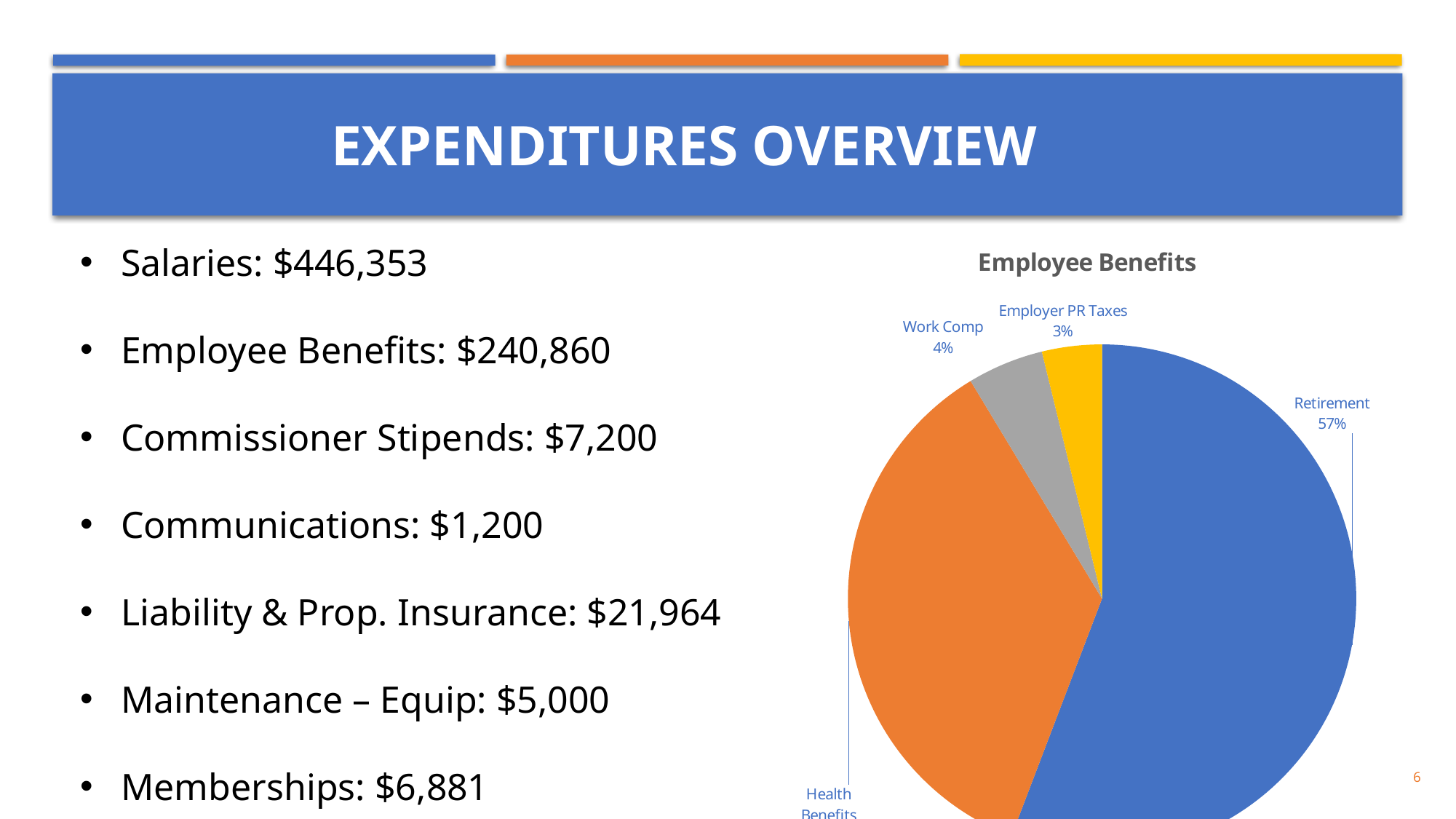
What share of the Employee Benefits pie is Work Comp? 4% Which is larger in the Employee Benefits pie, Work Comp or Employer PR Taxes? Work Comp What share of the Employee Benefits pie is Employer PR Taxes? 3% What colour is the Retirement slice in the Employee Benefits pie? Blue What is the title of the chart? Employee Benefits By how many percentage points does Retirement exceed Work Comp in the Employee Benefits pie? 53 percentage points Which is larger in the Employee Benefits pie, Retirement or Health Benefits? Retirement What share of the Employee Benefits pie is Retirement? 57% How many slices does the Employee Benefits pie chart have? 4 Which slice of the Employee Benefits pie is the smallest? Employer PR Taxes Which slice of the Employee Benefits pie is the largest? Retirement What kind of chart is shown on the slide? Pie chart